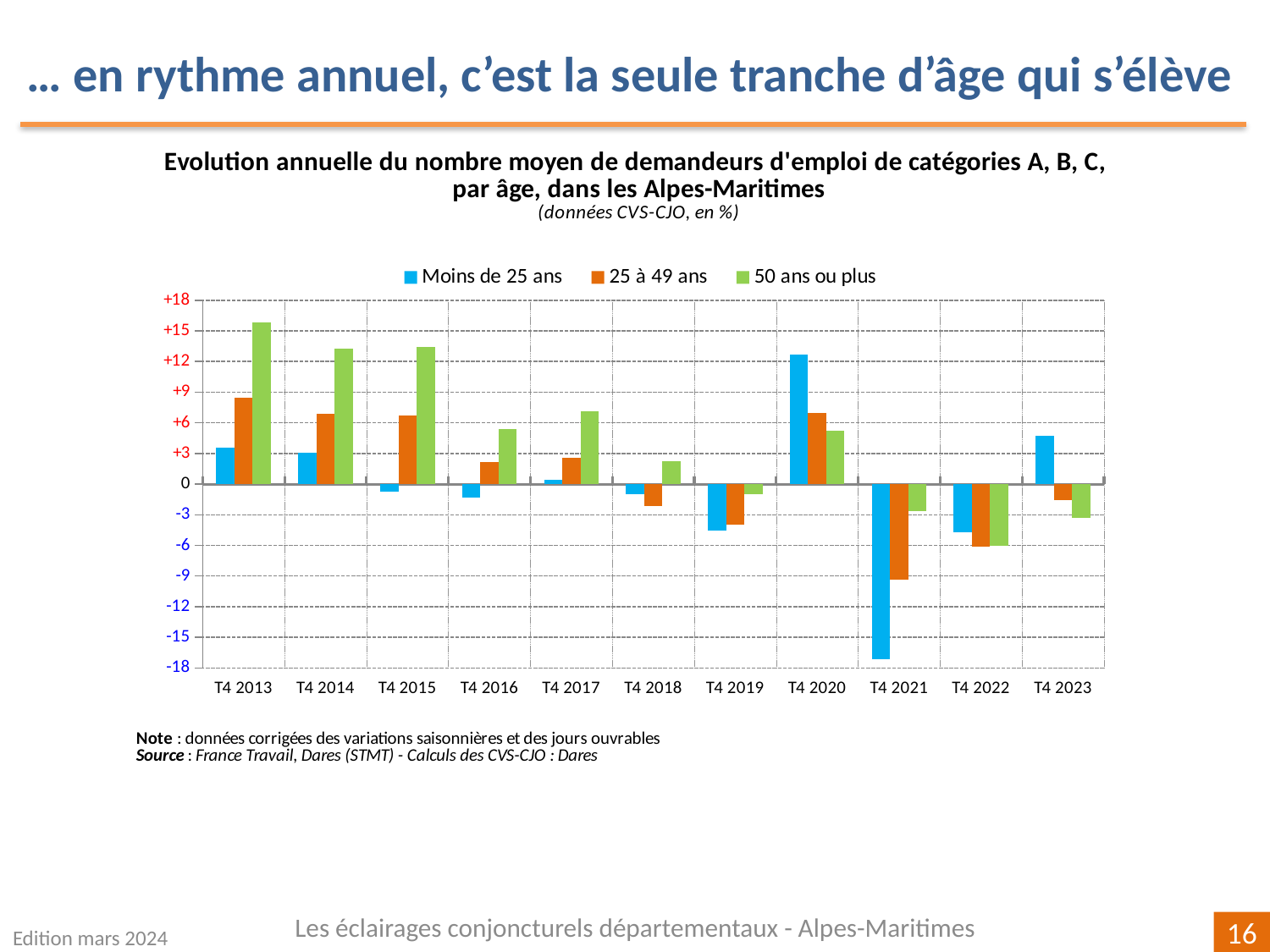
For the series '50 ans ou plus', in which period is the value highest? T4 2013 Is the value for 'Moins de 25 ans' in T4 2020 greater or less than +9? greater Which colour represents the series '25 à 49 ans' in the legend? orange In T4 2023, which series has the larger value: 'Moins de 25 ans' or '50 ans ou plus'? Moins de 25 ans For the series 'Moins de 25 ans', in which period is the value lowest? T4 2021 What kind of chart is shown on the slide? bar chart In T4 2020, which series has the larger value: 'Moins de 25 ans' or '25 à 49 ans'? Moins de 25 ans In T4 2021, which of the three series has the highest value? 50 ans ou plus Is the value for 'Moins de 25 ans' in T4 2021 greater or less than -15? less How many series does the legend list? 3 Is the value for '50 ans ou plus' in T4 2013 greater or less than +12? greater How many periods (categories) are shown on the x axis? 11